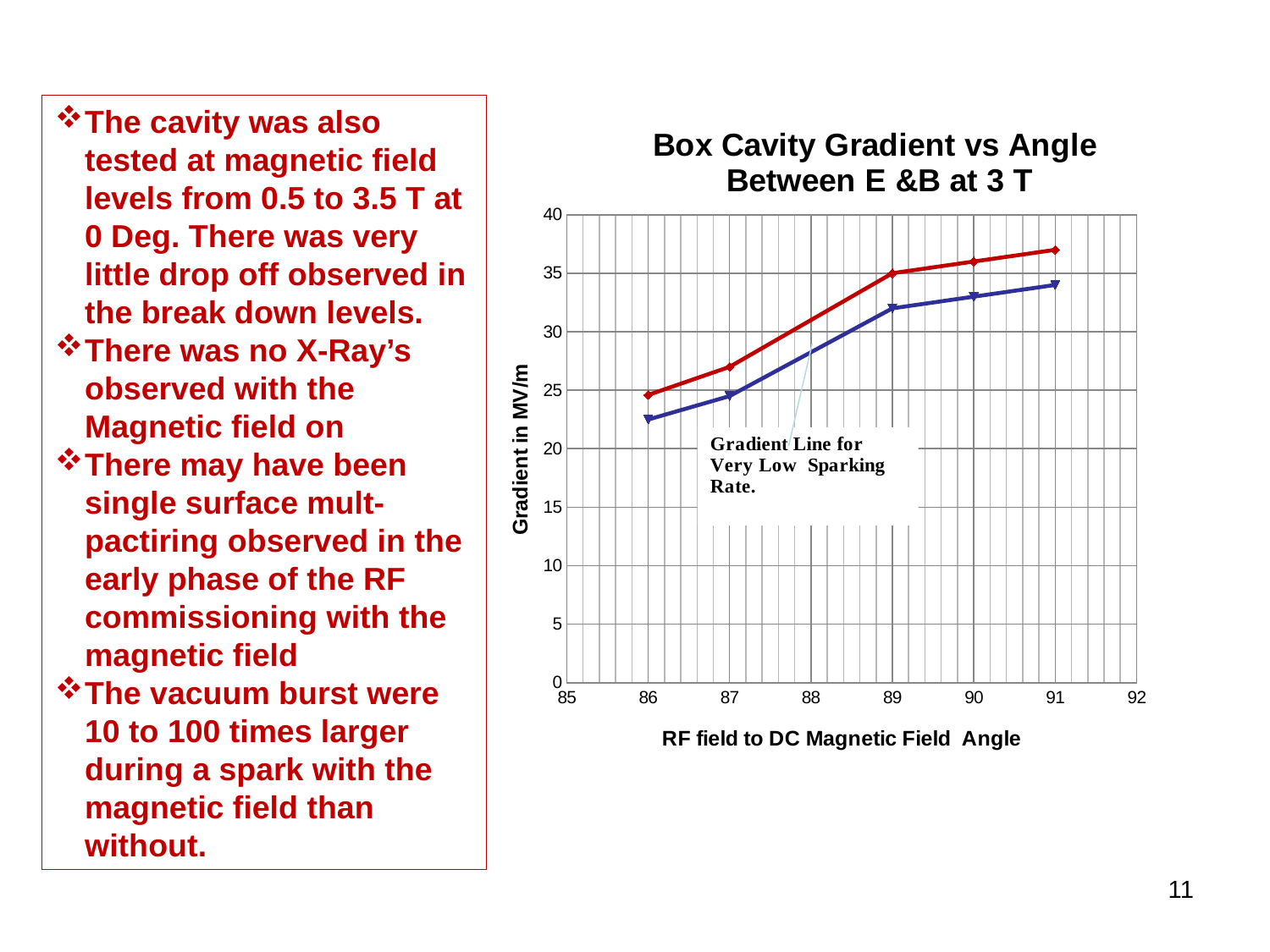
At which angle does the red line reach its highest gradient? 91 Do the gradient values rise or fall as the angle increases from 86 to 91? rise Is the value of the red line at an angle of 86 greater or less than 20? greater What kind of chart is shown on the slide? line chart How many data points are plotted on the red line? 5 Is the value of the red line at an angle of 91 greater or less than 35? greater Is the value of the blue line at an angle of 86 greater or less than 25? less What is the title of the chart? Box Cavity Gradient vs Angle Between E &B at 3 T At an angle of 89, which line has the higher gradient, the red line or the blue line? red line What does the annotation inside the chart say the lower (blue) line represents? Gradient Line for Very Low Sparking Rate.